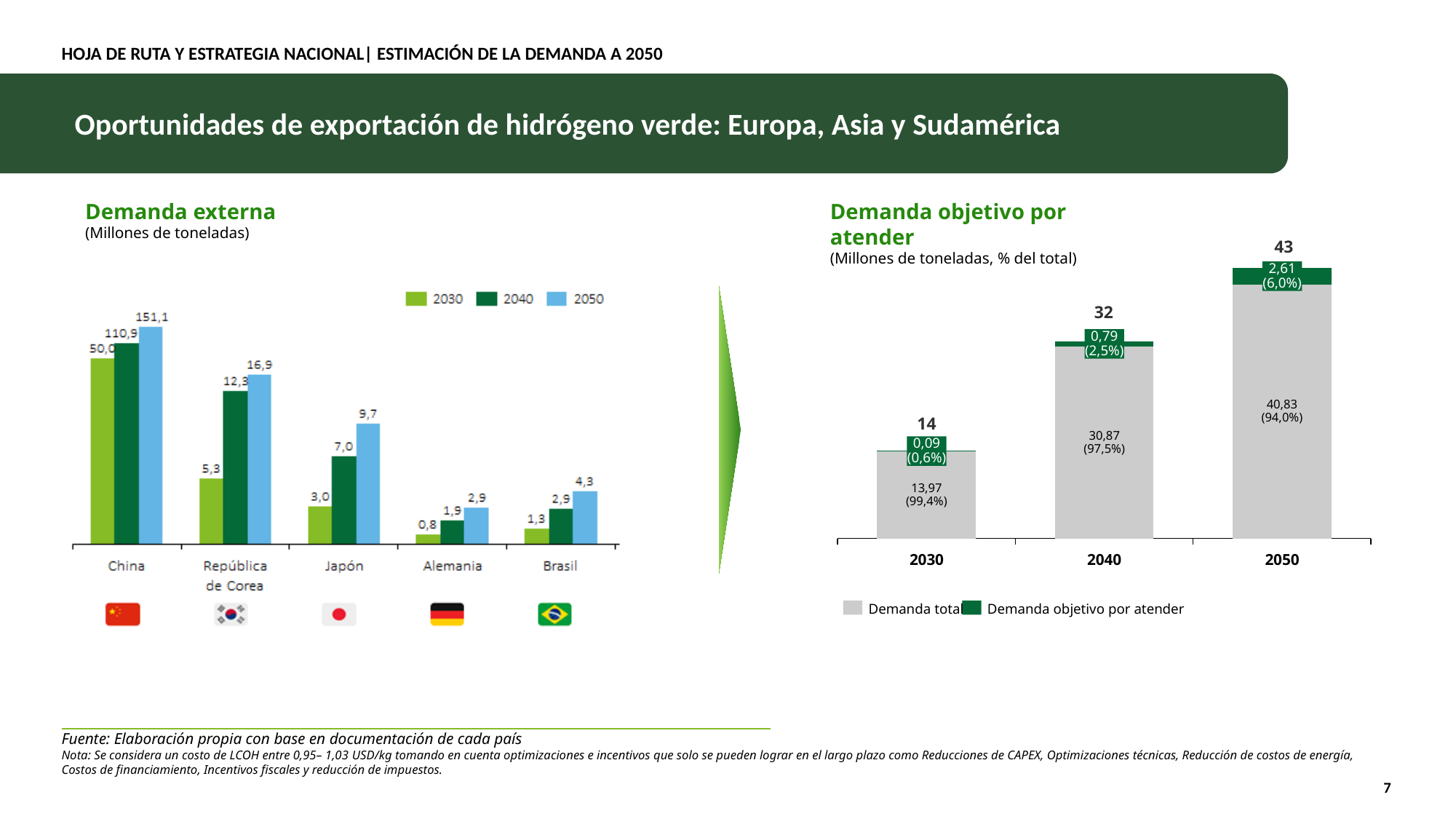
How many series does the legend of the 'Demanda externa' chart list? 3 In the 'Demanda externa' chart, what is the value for China in 2050? 151,1 What type of chart is the 'Demanda objetivo por atender' chart? Stacked bar chart In the 'Demanda objetivo por atender' chart, do the totals rise or fall from 2030 to 2050? Rise In the 'Demanda externa' chart, which country has the highest value in 2030? China In the 'Demanda externa' chart, which is larger: Brasil in 2050 or Japón in 2030? Brasil in 2050 How many countries are shown in the 'Demanda externa' chart? 5 In the 'Demanda objetivo por atender' chart, what is the total of the stacked bar for 2050? 43 In the 'Demanda externa' chart, what is the value for Japón in 2040? 7,0 In the 'Demanda externa' chart, what is the difference between the 2050 and 2030 values for República de Corea? 11,6 In the 'Demanda externa' chart, which country has the lowest value in 2050? Alemania In the 'Demanda objetivo por atender' chart, what is the value of 'Demanda objetivo por atender' in 2040? 0,79